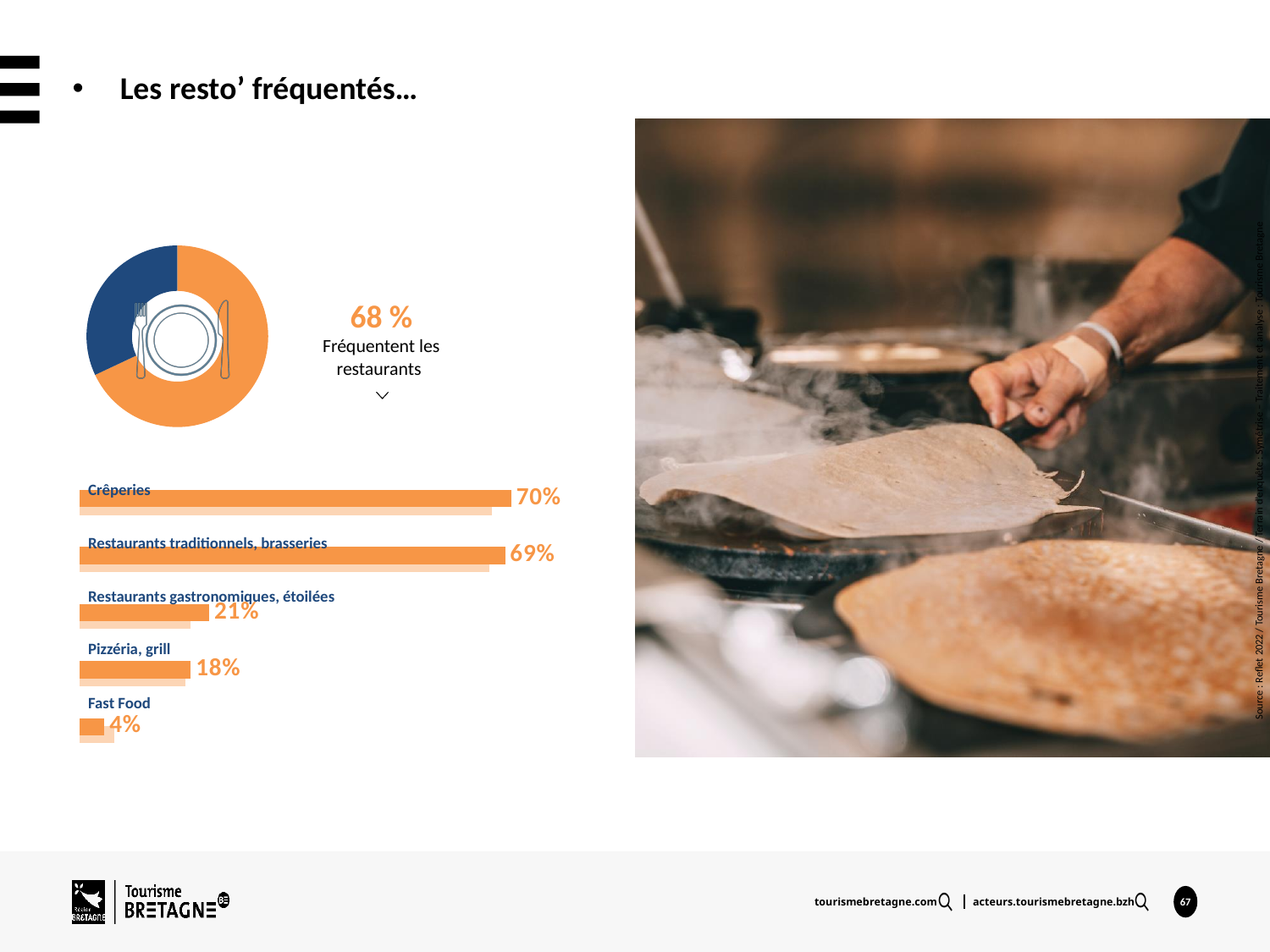
In the bar chart, which is larger: the value for Pizzéria, grill or the value for Restaurants gastronomiques, étoilées? Restaurants gastronomiques, étoilées In the bar chart, what is the difference between the values for Crêperies and Fast Food? 66% In the bar chart, what is the value for Crêperies? 70% In the bar chart, what is the value for Fast Food? 4% How many categories does the bar chart show? 5 In the bar chart, which category has the lowest value? Fast Food In the bar chart, what is the value for Restaurants traditionnels, brasseries? 69% In the bar chart, what is the difference between the values for Restaurants gastronomiques, étoilées and Pizzéria, grill? 3% What percentage does the donut chart on the left show for people who frequent restaurants? 68 % In the bar chart, what is the value for Pizzéria, grill? 18% In the bar chart, which category has the highest value? Crêperies In the bar chart, what is the value for Restaurants gastronomiques, étoilées? 21%